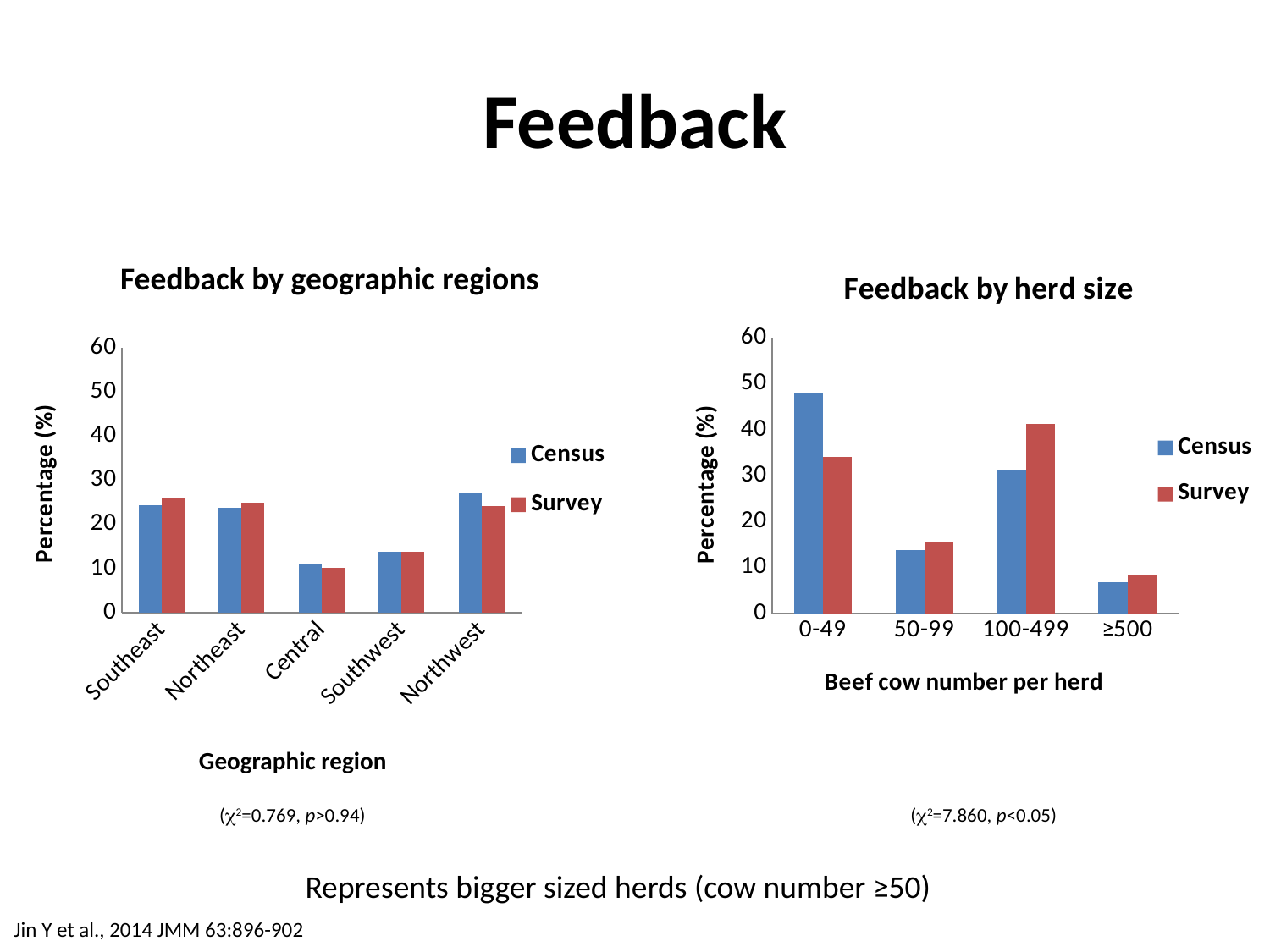
What kind of chart is the 'Feedback by geographic regions' chart? bar chart On the 'Feedback by herd size' chart, is the Census value for 0-49 greater or less than 40? greater How many series does the legend of the 'Feedback by herd size' chart list? 2 On the 'Feedback by herd size' chart, which herd size category has the lowest Survey value? ≥500 On the 'Feedback by geographic regions' chart, which region has the lowest Census value? Central On the 'Feedback by herd size' chart, for the 0-49 category, which is larger: Census or Survey? Census How many herd size categories are shown on the 'Feedback by herd size' chart? 4 How many geographic regions are shown on the 'Feedback by geographic regions' chart? 5 On the 'Feedback by herd size' chart, which herd size category has the highest Census value? 0-49 On the 'Feedback by geographic regions' chart, is the Census value for Central greater or less than 20? less On the 'Feedback by geographic regions' chart, which region has the highest Census value? Northwest On the 'Feedback by herd size' chart, for the 100-499 category, which is larger: Census or Survey? Survey